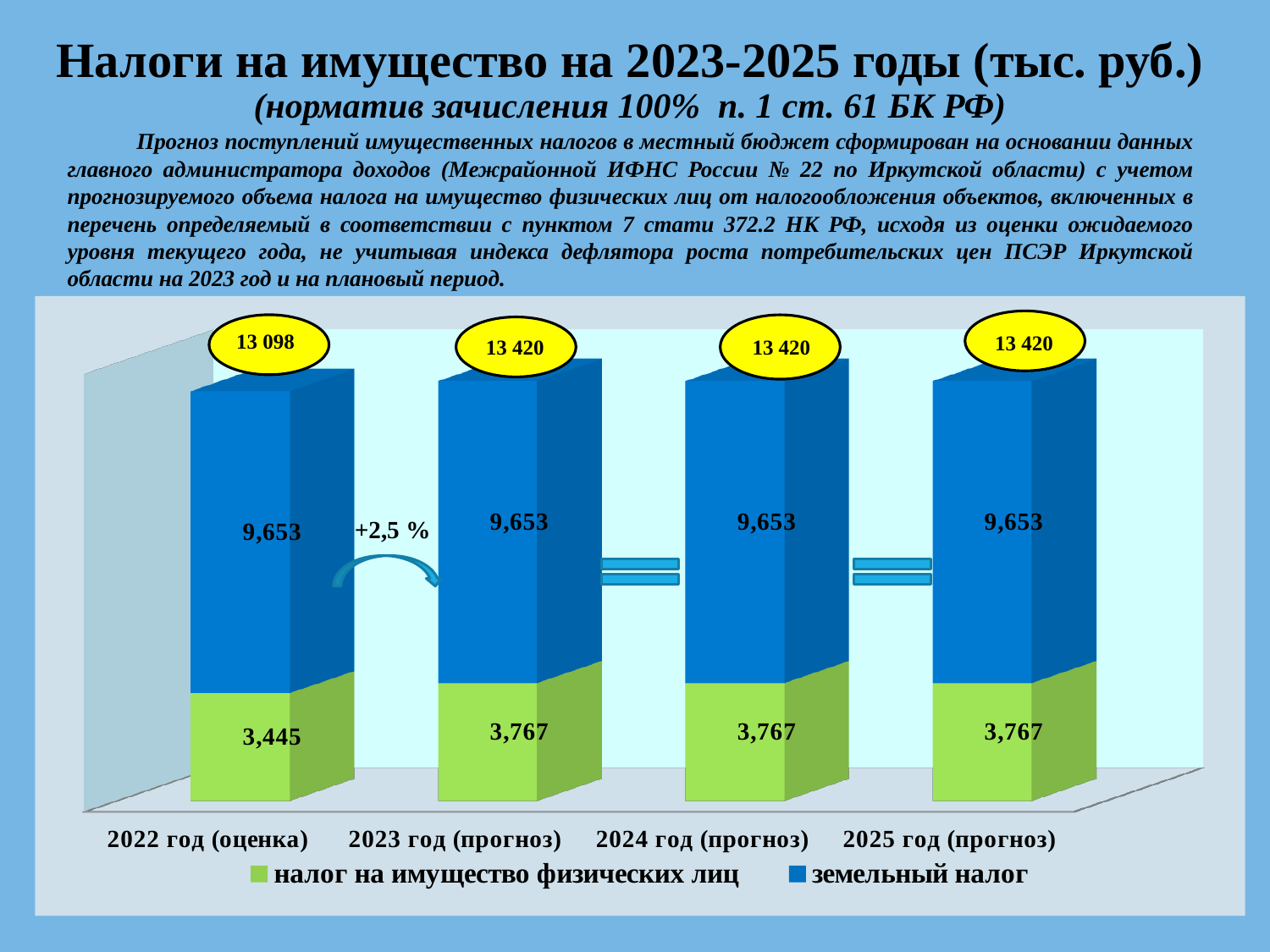
What is the total shown above the bar for 2022 год (оценка)? 13 098 What kind of chart is shown on the slide? stacked bar chart What is the difference between the налог на имущество физических лиц values for 2023 год (прогноз) and 2022 год (оценка)? 322 How many year categories are shown on the x axis? 4 How many series does the legend list? 2 What is the value of налог на имущество физических лиц for 2022 год (оценка)? 3,445 What is the total shown above the bar for 2025 год (прогноз)? 13 420 What is the value of земельный налог for 2022 год (оценка)? 9,653 What is the value of налог на имущество физических лиц for 2023 год (прогноз)? 3,767 Which year has the lowest value for налог на имущество физических лиц? 2022 год (оценка) What percentage change is annotated between the 2022 and 2023 bars? +2,5 % Which is larger for 2024 год (прогноз): земельный налог or налог на имущество физических лиц? земельный налог